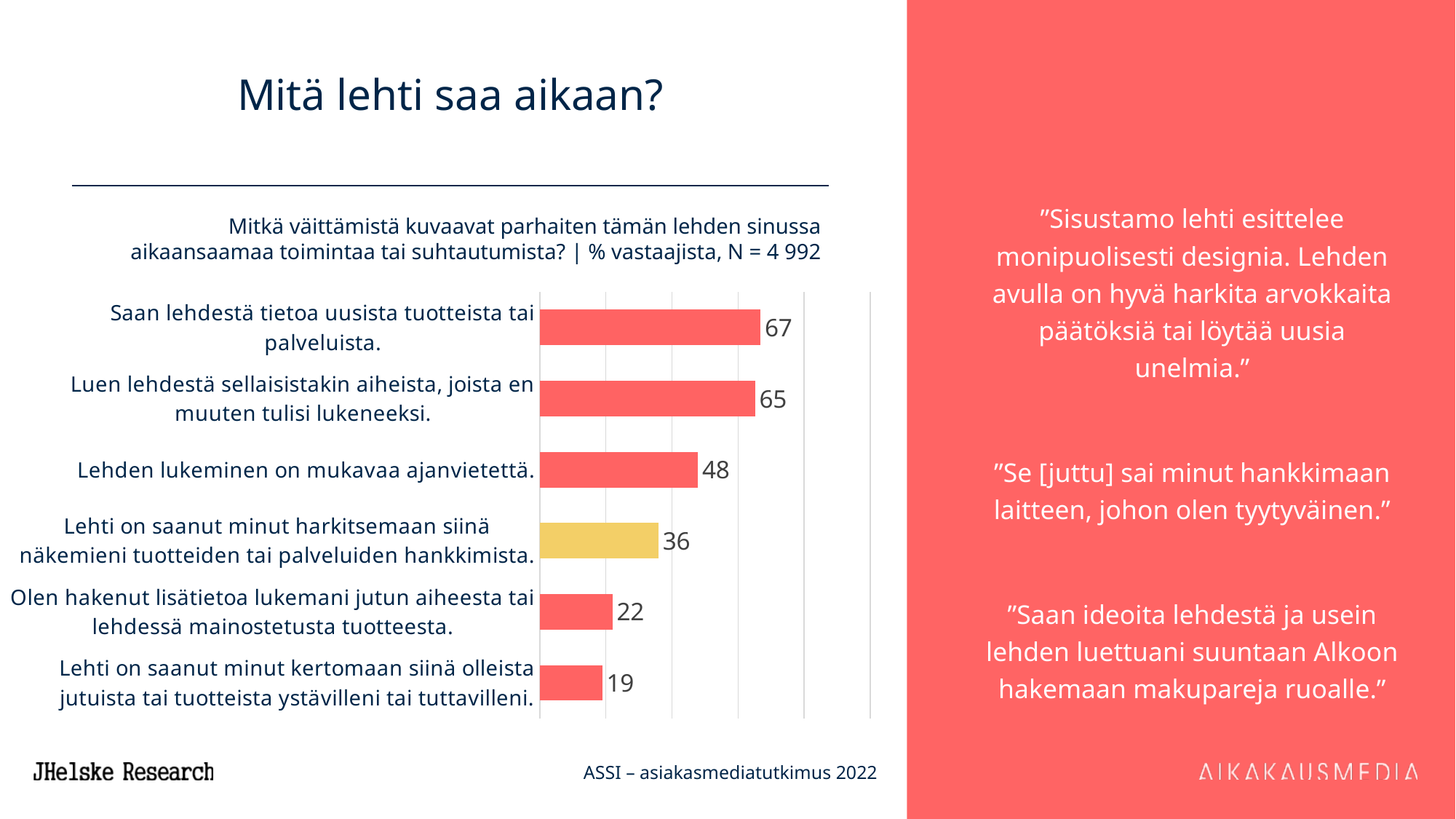
What value is shown for "Olen hakenut lisätietoa lukemani jutun aiheesta tai lehdessä mainostetusta tuotteesta."? 22 What kind of chart is shown on the slide? Bar chart What is the difference between the values for "Saan lehdestä tietoa uusista tuotteista tai palveluista." and "Lehden lukeminen on mukavaa ajanvietettä."? 19 What value is shown for "Saan lehdestä tietoa uusista tuotteista tai palveluista."? 67 What value is shown for "Lehti on saanut minut harkitsemaan siinä näkemieni tuotteiden tai palveluiden hankkimista."? 36 What is the sample size (N) stated in the chart subtitle? N = 4 992 What value is shown for "Lehden lukeminen on mukavaa ajanvietettä."? 48 Which statement has the lowest value? Lehti on saanut minut kertomaan siinä olleista jutuista tai tuotteista ystävilleni tai tuttavilleni. How many statements (bars) are shown in the chart? 6 Which statement has the highest value? Saan lehdestä tietoa uusista tuotteista tai palveluista. Which has a larger value: "Lehden lukeminen on mukavaa ajanvietettä." or "Lehti on saanut minut harkitsemaan siinä näkemieni tuotteiden tai palveluiden hankkimista."? Lehden lukeminen on mukavaa ajanvietettä. Which bar is coloured yellow instead of red? Lehti on saanut minut harkitsemaan siinä näkemieni tuotteiden tai palveluiden hankkimista.